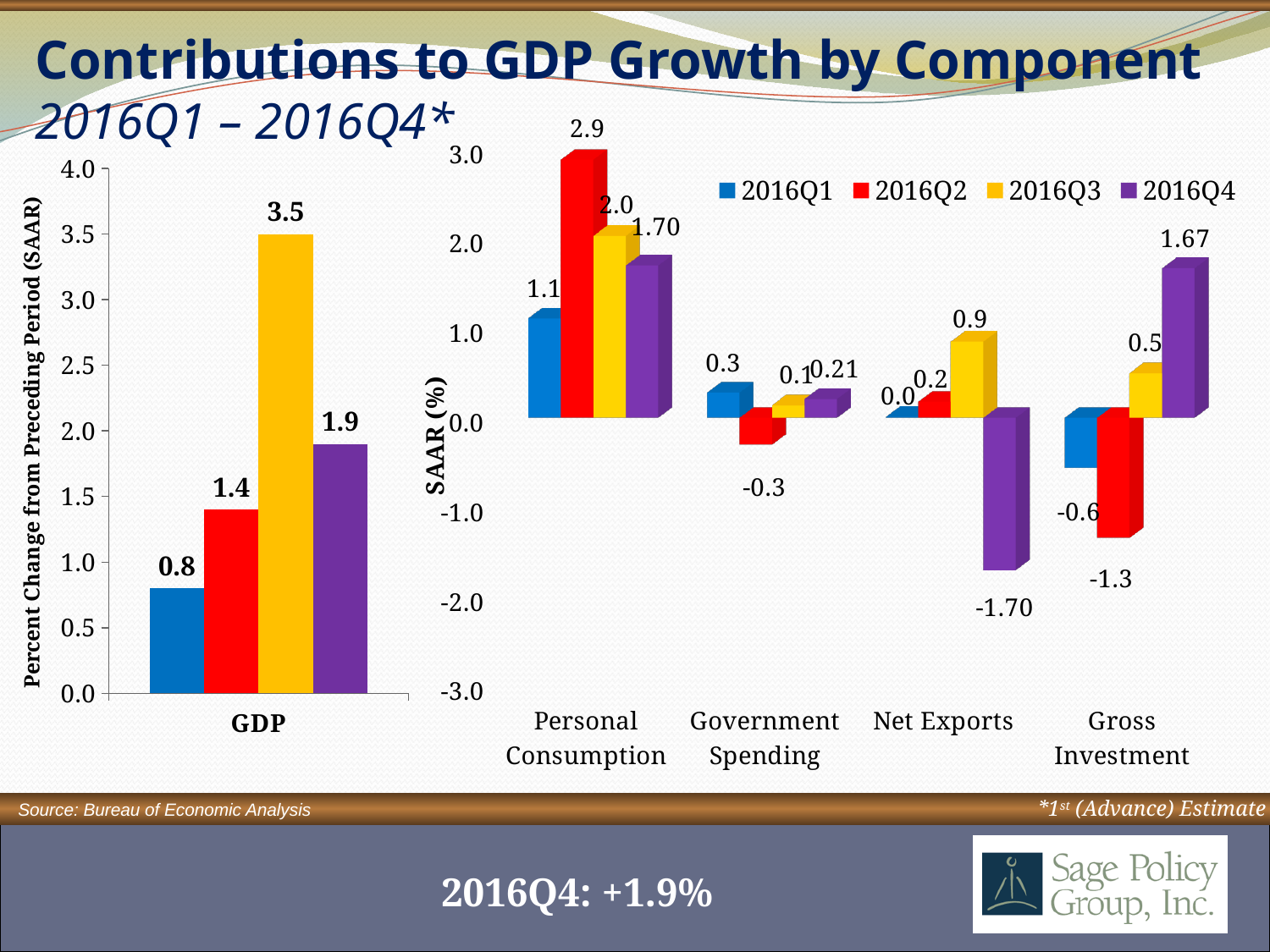
In the right chart, which series has the lowest value in Gross Investment? 2016Q2 In the left chart (GDP), how many bars are plotted? 4 In the right chart, what is the value for 2016Q4 in Net Exports? -1.70 What kind of chart is the right chart? Bar chart In the right chart, what is the value for 2016Q4 in Gross Investment? 1.67 In the right chart, what is the value for 2016Q2 in Personal Consumption? 2.9 In the right chart, how many categories are shown on the x axis? 4 In the left chart (GDP), what is the difference between the highest bar (3.5) and the lowest bar (0.8)? 2.7 In the right chart, how many series does the legend list? 4 In the right chart, which is larger for Government Spending: 2016Q1 or 2016Q3? 2016Q1 In the left chart (GDP), what is the highest value shown? 3.5 In the left chart (GDP), what is the lowest value shown? 0.8